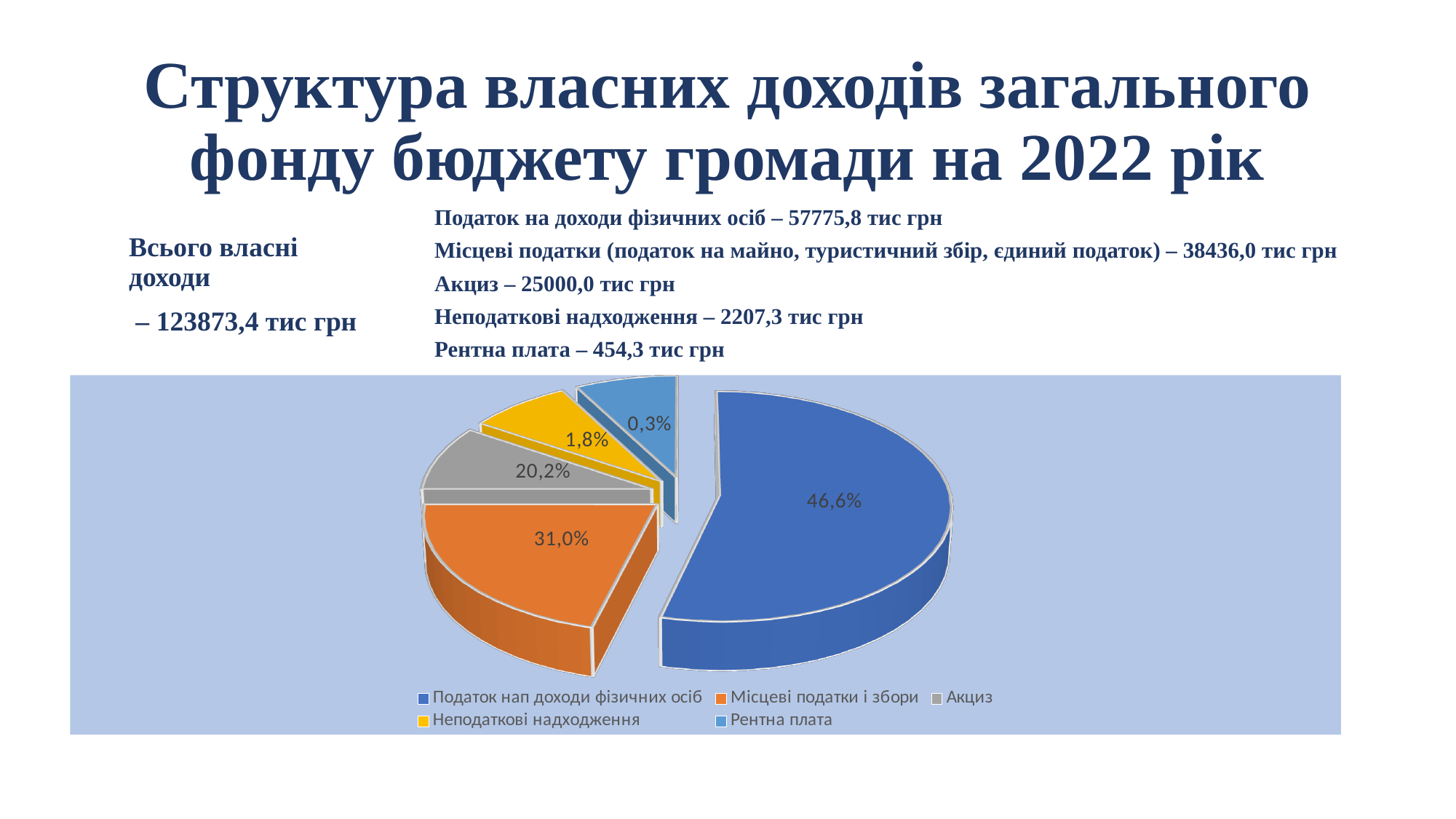
Which category has the largest slice of the pie? Податок на доходи фізичних осіб How many slices does the pie chart have? 5 What share of the pie does the slice for Податок на доходи фізичних осіб have? 46,6% What share of the pie does the slice for Рентна плата have? 0,3% What share of the pie does the slice for Неподаткові надходження have? 1,8% What colour is the slice for Акциз in the pie chart? Gray Which category has the smallest slice of the pie? Рентна плата What is the difference in percentage points between the slices for Податок на доходи фізичних осіб and Місцеві податки і збори? 15,6% Which slice is larger: Акциз or Неподаткові надходження? Акциз What kind of chart is shown on the slide? Pie chart